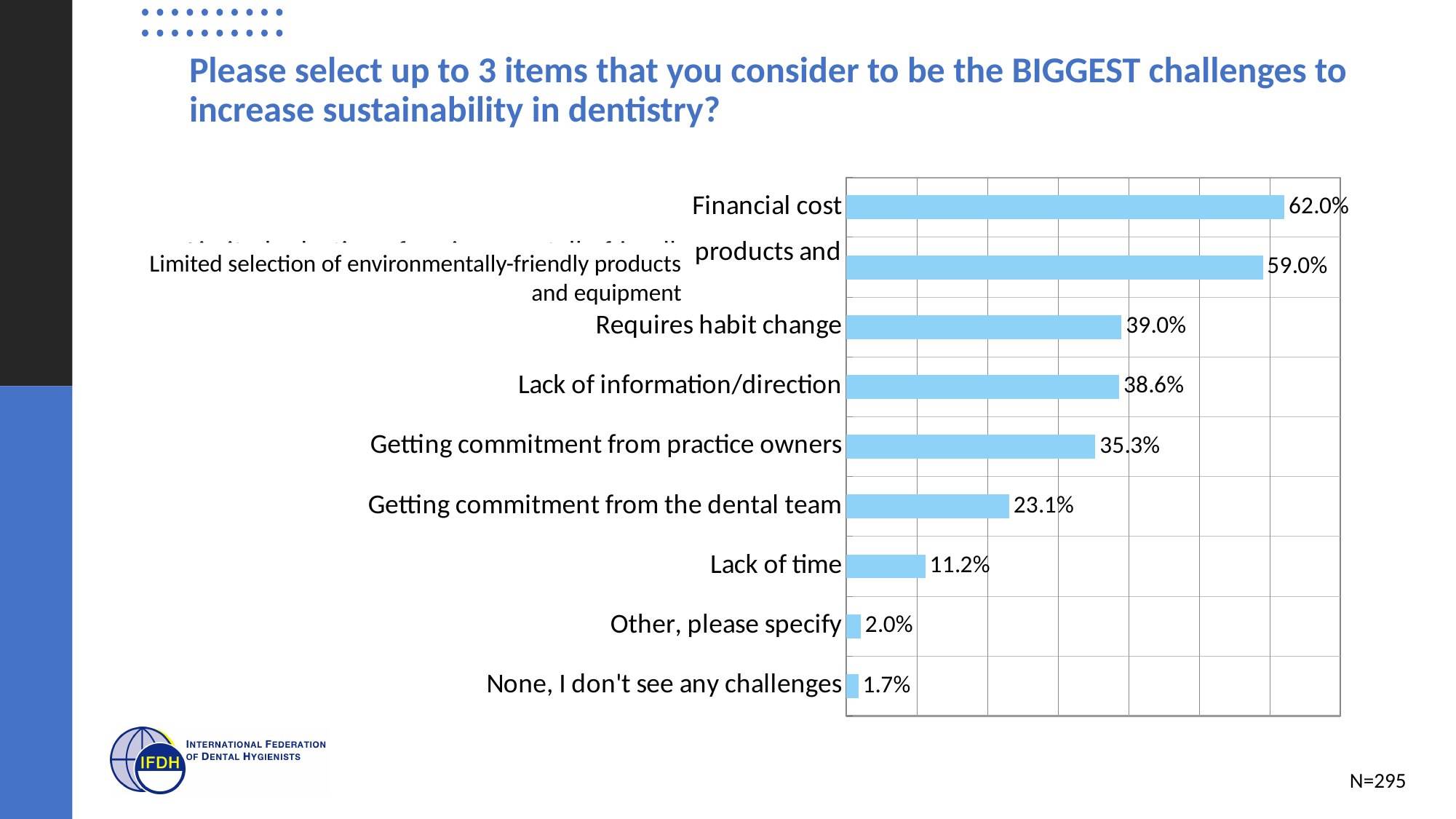
What sample size (N) is noted on the slide? N=295 What percentage of respondents selected Financial cost as one of the biggest challenges? 62.0% What is the value shown for Requires habit change? 39.0% What is the value for Getting commitment from the dental team? 23.1% What percentage is shown for Limited selection of environmentally-friendly products and equipment? 59.0% What is the difference in percentage points between Financial cost and Limited selection of environmentally-friendly products and equipment? 3.0 percentage points Which is larger: the value for Getting commitment from practice owners or the value for Getting commitment from the dental team? Getting commitment from practice owners Which challenge has the highest percentage in the chart? Financial cost What type of chart is shown on the slide? Bar chart What percentage is shown for Lack of time? 11.2% How many categories (challenges) are plotted in the chart? 9 What is the difference in percentage points between Getting commitment from practice owners and Lack of time? 24.1 percentage points